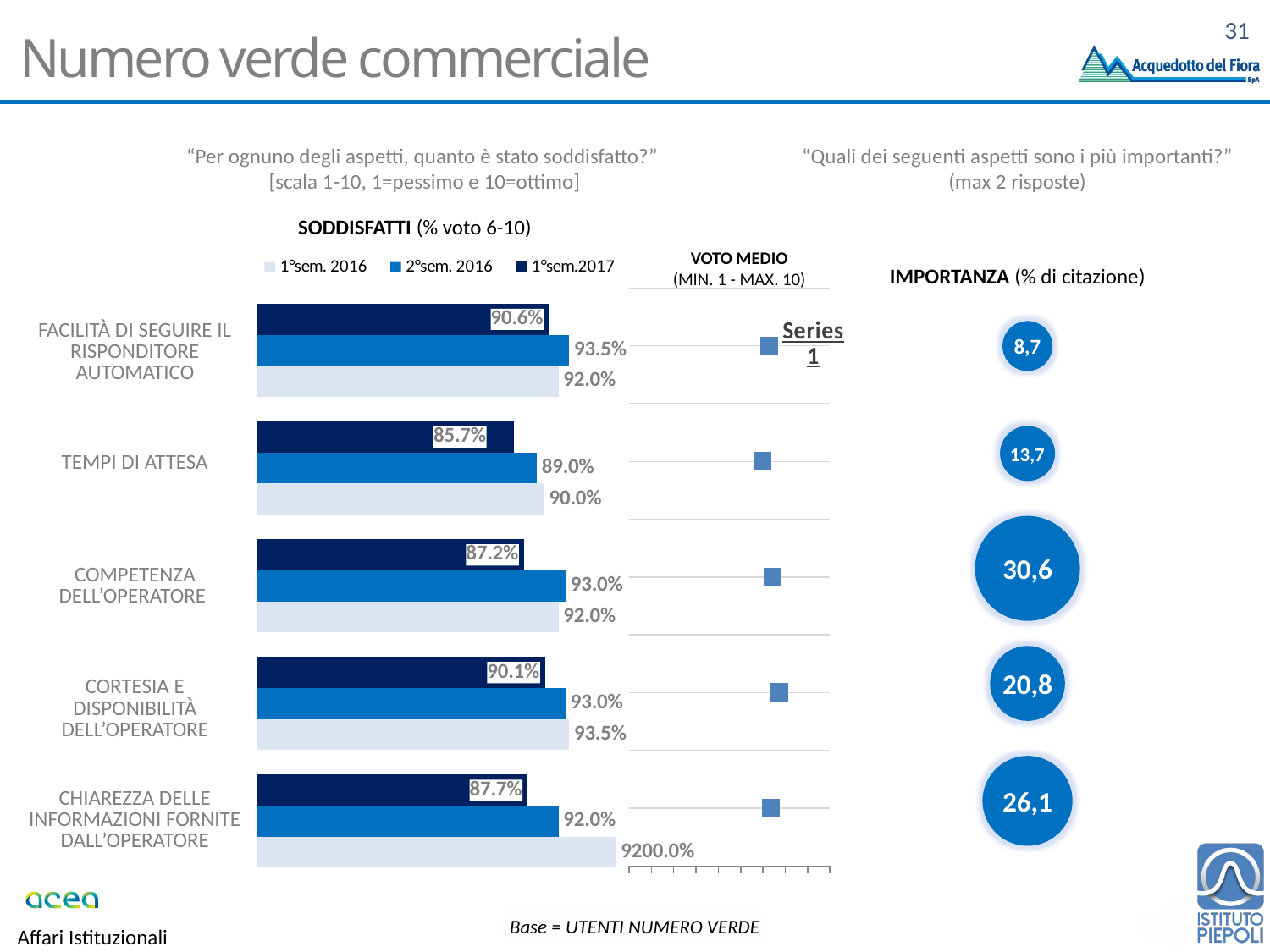
In the SODDISFATTI chart, what is the 1°sem. 2016 value for CORTESIA E DISPONIBILITÀ DELL'OPERATORE? 93.5% In the SODDISFATTI chart, which category has the highest 1°sem.2017 value? FACILITÀ DI SEGUIRE IL RISPONDITORE AUTOMATICO In the IMPORTANZA (% di citazione) chart, which aspect has the highest value? COMPETENZA DELL'OPERATORE How many categories (aspects) are shown in the SODDISFATTI chart? 5 What kind of chart is the SODDISFATTI chart? Bar chart How many series does the legend of the SODDISFATTI chart list? 3 In the IMPORTANZA (% di citazione) chart, what is the value for TEMPI DI ATTESA? 13,7 In the SODDISFATTI chart, what is the 1°sem.2017 value for TEMPI DI ATTESA? 85.7% In the SODDISFATTI chart, for TEMPI DI ATTESA, which is larger: the 1°sem. 2016 value or the 2°sem. 2016 value? 1°sem. 2016 In the SODDISFATTI chart, what is the 2°sem. 2016 value for FACILITÀ DI SEGUIRE IL RISPONDITORE AUTOMATICO? 93.5% In the SODDISFATTI chart, what is the difference between the 2°sem. 2016 and 1°sem.2017 values for COMPETENZA DELL'OPERATORE? 5.8 percentage points In the SODDISFATTI chart, which category has the lowest 1°sem.2017 value? TEMPI DI ATTESA